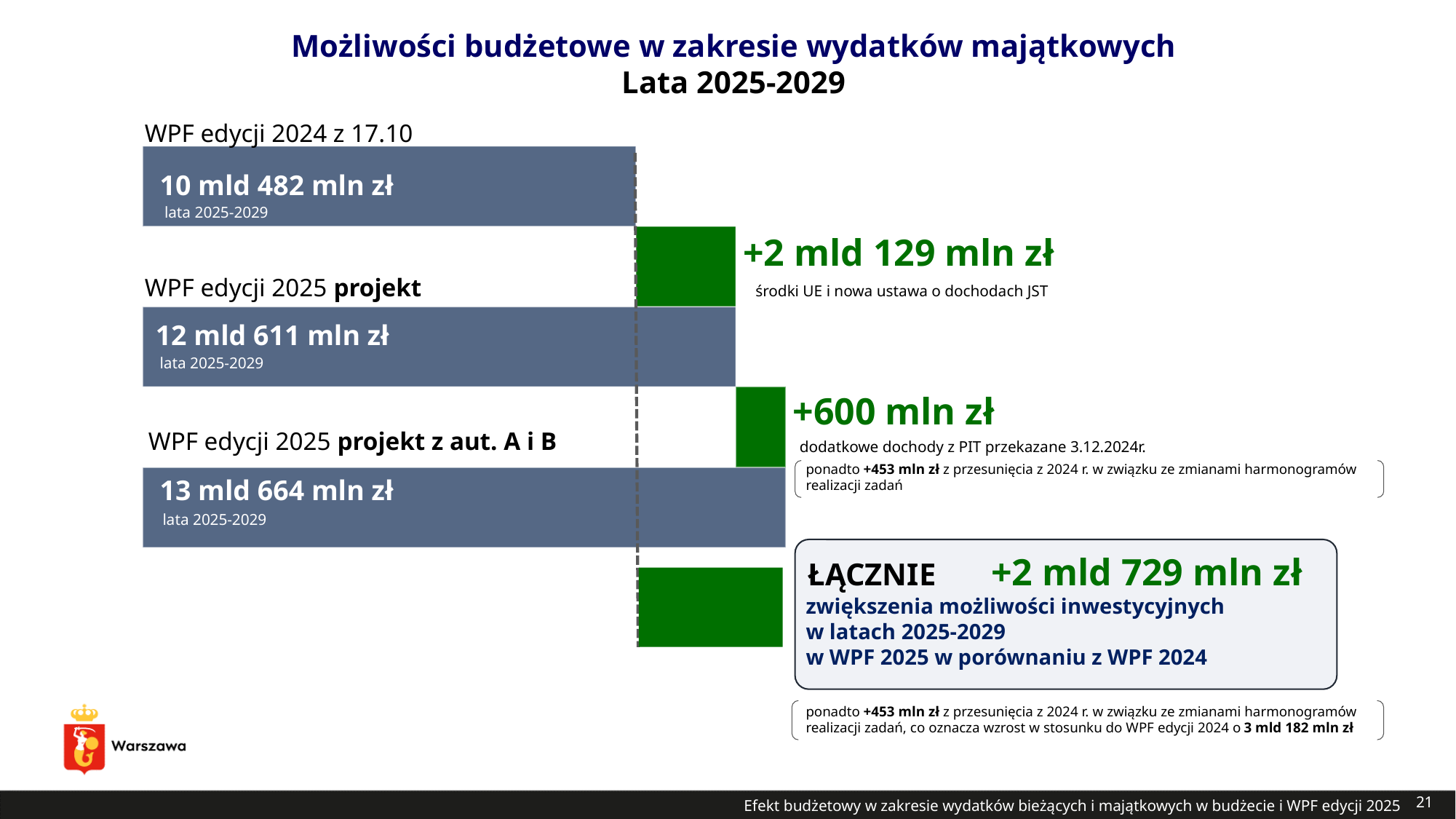
What is the total increase (ŁĄCZNIE) shown in the chart? +2 mld 729 mln zł Do the values of the grey bars rise or fall from top to bottom? Rise What kind of chart is shown on the slide? Bar chart What increase is shown between WPF edycji 2024 and WPF edycji 2025 projekt? +2 mld 129 mln zł What is the value shown for WPF edycji 2024 z 17.10? 10 mld 482 mln zł Which is larger: the value for WPF edycji 2025 projekt or WPF edycji 2024 z 17.10? WPF edycji 2025 projekt What is the value shown for WPF edycji 2025 projekt z aut. A i B? 13 mld 664 mln zł Which of the three WPF editions has the lowest value? WPF edycji 2024 z 17.10 How many grey bars (WPF editions) are shown in the chart? 3 Which of the three WPF editions has the highest value? WPF edycji 2025 projekt z aut. A i B What increase is shown between WPF edycji 2025 projekt and WPF edycji 2025 projekt z aut. A i B? +600 mln zł What is the value shown for WPF edycji 2025 projekt? 12 mld 611 mln zł